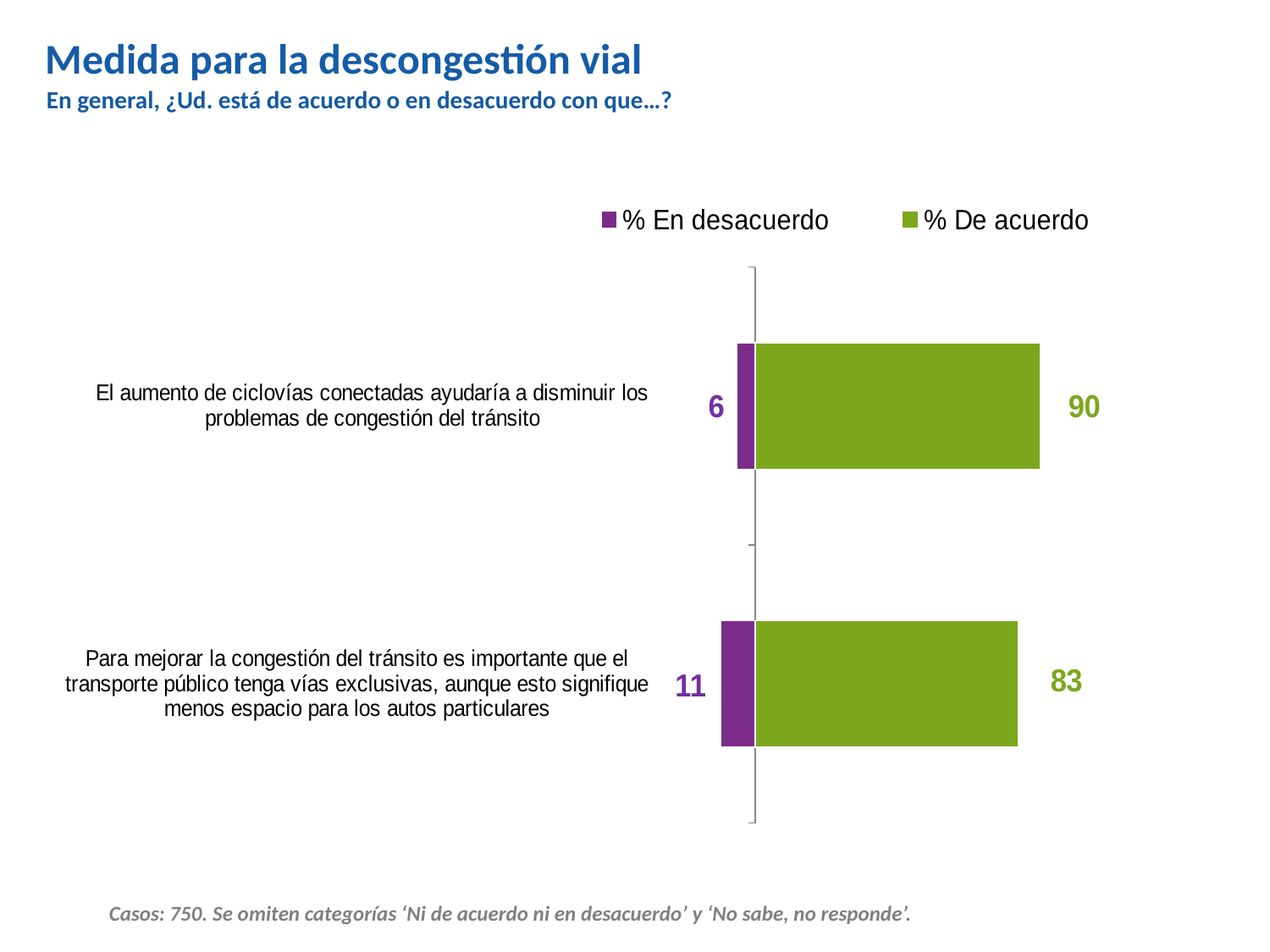
What is the difference between the '% De acuerdo' values of the two statements? 7 How many statements (categories) are shown in the chart? 2 What kind of chart is shown on the slide? Bar chart What is the difference between the '% En desacuerdo' values of the two statements? 5 Which statement has the highest '% De acuerdo' value? El aumento de ciclovías conectadas ayudaría a disminuir los problemas de congestión del tránsito What is the '% De acuerdo' value for 'El aumento de ciclovías conectadas ayudaría a disminuir los problemas de congestión del tránsito'? 90 What is the '% De acuerdo' value for the statement about public transport having exclusive lanes ('Para mejorar la congestión del tránsito es importante que el transporte público tenga vías exclusivas...')? 83 Which statement has the lowest '% En desacuerdo' value? El aumento de ciclovías conectadas ayudaría a disminuir los problemas de congestión del tránsito How many series does the legend list? 2 What is the '% En desacuerdo' value for 'El aumento de ciclovías conectadas ayudaría a disminuir los problemas de congestión del tránsito'? 6 Which is larger: the '% En desacuerdo' for the ciclovías statement or the '% En desacuerdo' for the exclusive lanes statement? The exclusive lanes statement (11) What is the '% En desacuerdo' value for the statement about public transport having exclusive lanes? 11